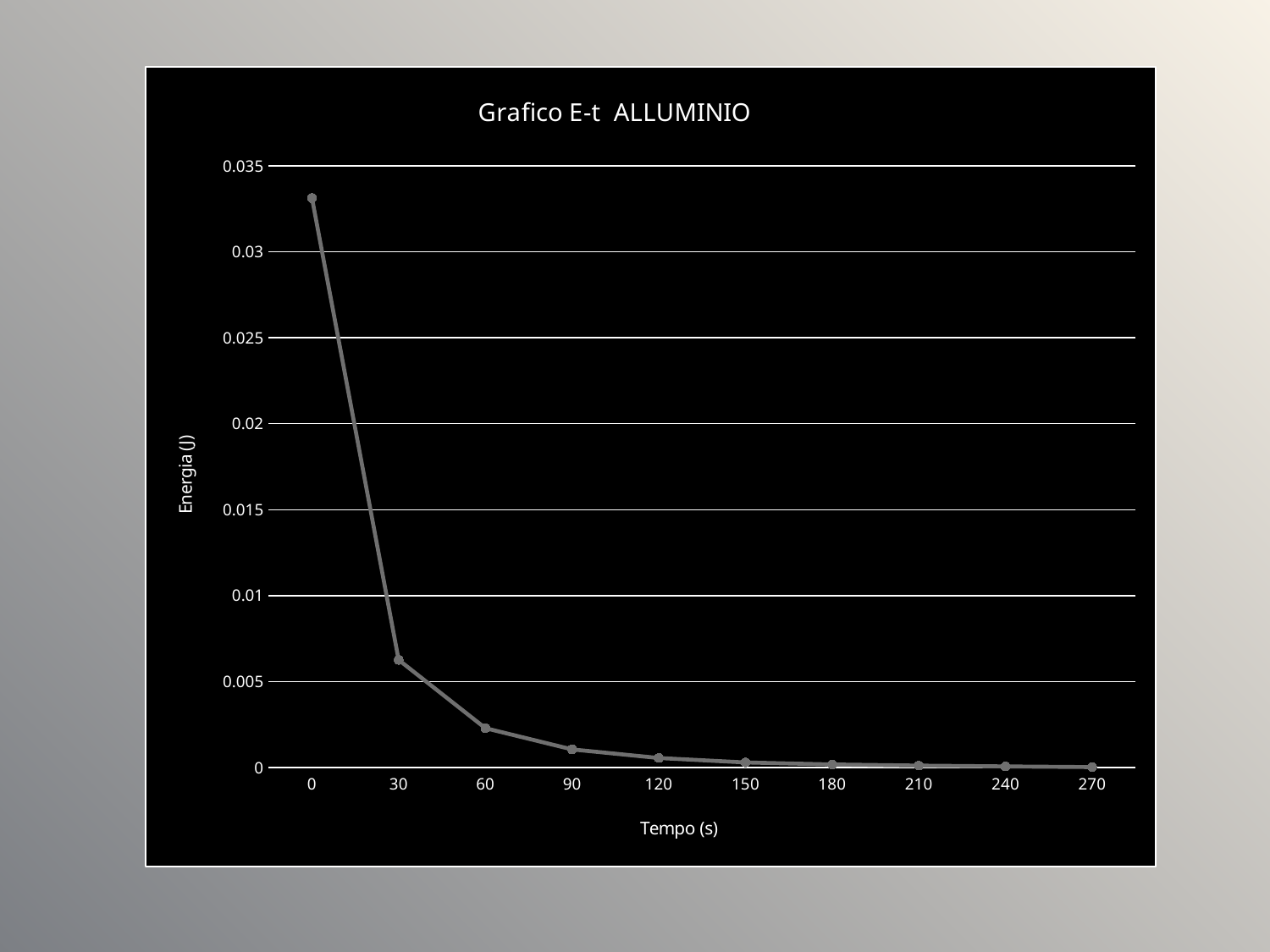
How many data points are plotted on the line? 10 Is the energy value at Tempo 60 greater or less than 0.005? less Is the energy value at Tempo 30 greater or less than 0.005? greater Is the energy value at Tempo 0 greater or less than 0.03? greater At which time (Tempo) is the energy value highest? 0 Which has the larger energy value, Tempo 0 or Tempo 90? 0 Which has the larger energy value, Tempo 30 or Tempo 60? 30 What is the title of the chart? Grafico E-t ALLUMINIO What is the label of the x axis? Tempo (s) What kind of chart is shown on the slide? line chart Do the energy values rise or fall as time increases along the x axis? fall